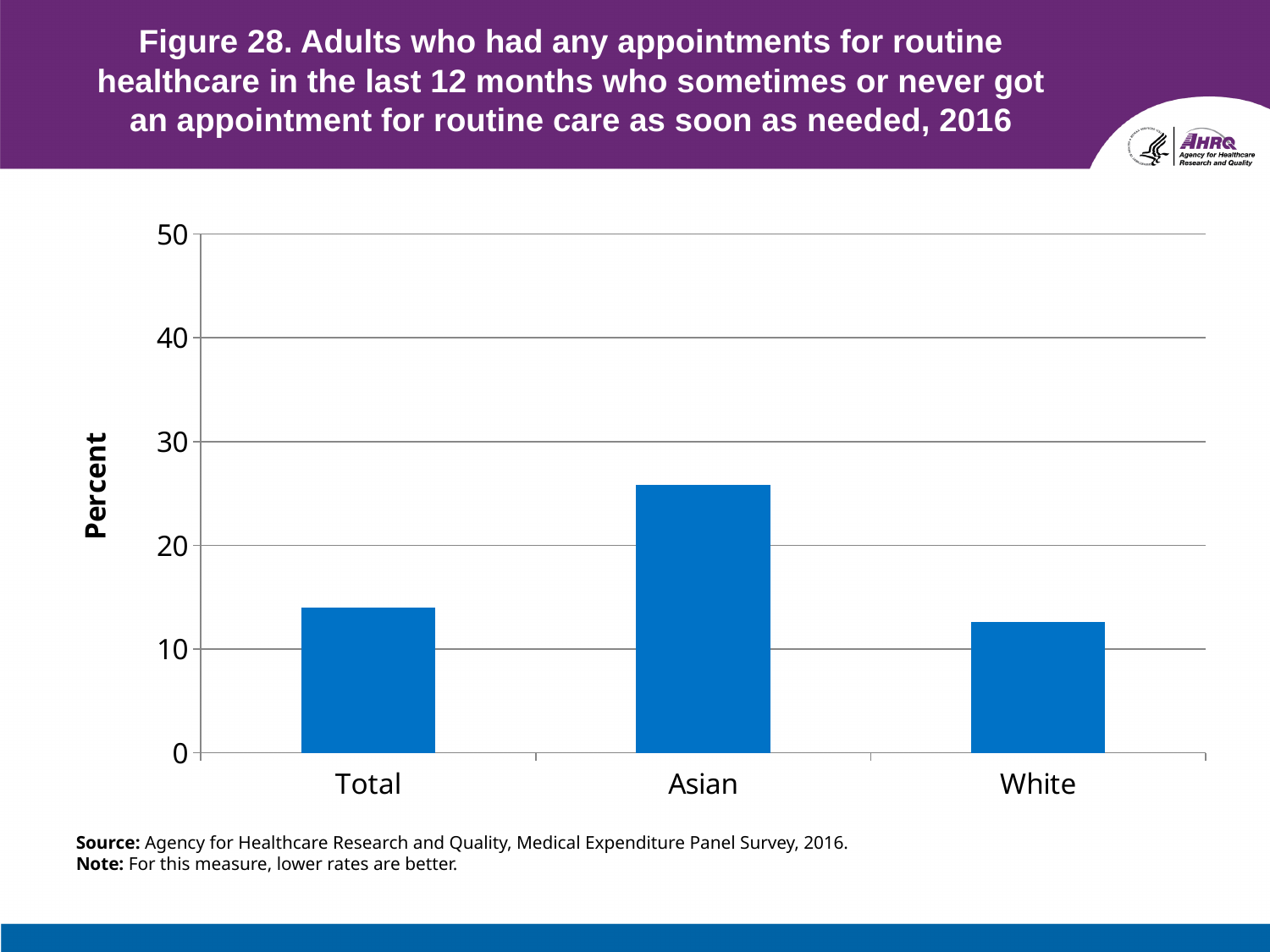
How many categories are shown on the x axis? 3 What kind of chart is shown on the slide? bar chart Which category has the lowest value? White Is the value for Asian greater or less than 30? less Is the value for White greater or less than 20? less Which category has the highest value? Asian Is the value for Asian greater or less than 20? greater Which is larger, the value for Asian or the value for Total? Asian What is the maximum value shown on the y axis? 50 What is the label on the y axis? Percent